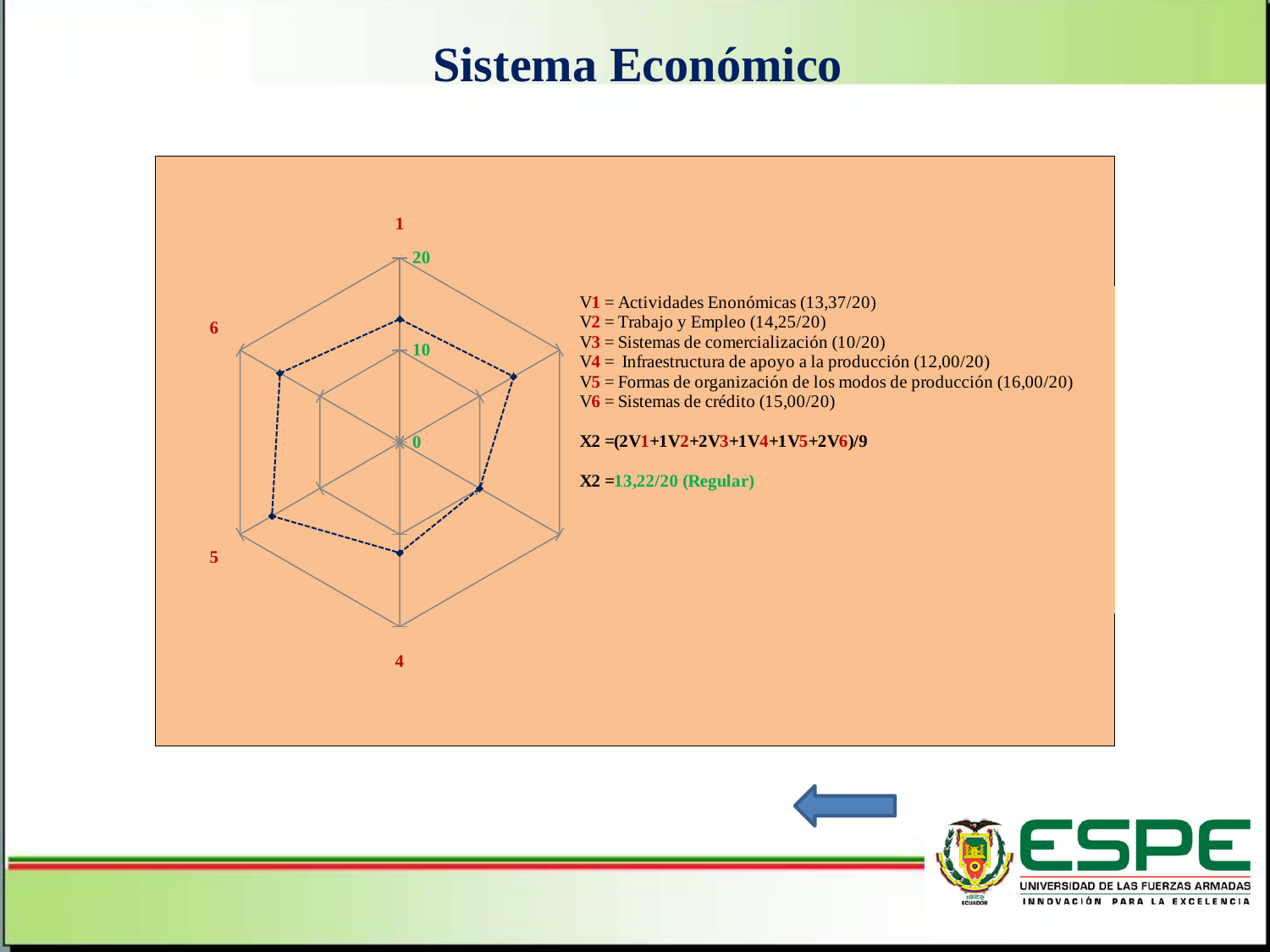
According to the slide text, what is the value of V1 (Actividades Enonómicas)? 13,37/20 According to the slide text, what is the value of V5 (Formas de organización de los modos de producción)? 16,00/20 What is the difference between the values of V6 and V4? 3,00 What is the maximum value shown on the radar chart's axis scale? 20 Which variable has the highest value on the radar chart? V5 How many axes (variables) does the radar chart have? 6 Which variable has the lowest value according to the slide? V3 What is the final X2 score shown on the slide? 13,22/20 (Regular) Which is larger, the value for V5 or the value for V6? V5 According to the slide text, what is the value of V6 (Sistemas de crédito)? 15,00/20 What kind of chart is shown on the slide? radar chart Is the value plotted on axis 1 of the radar chart greater or less than 10? greater